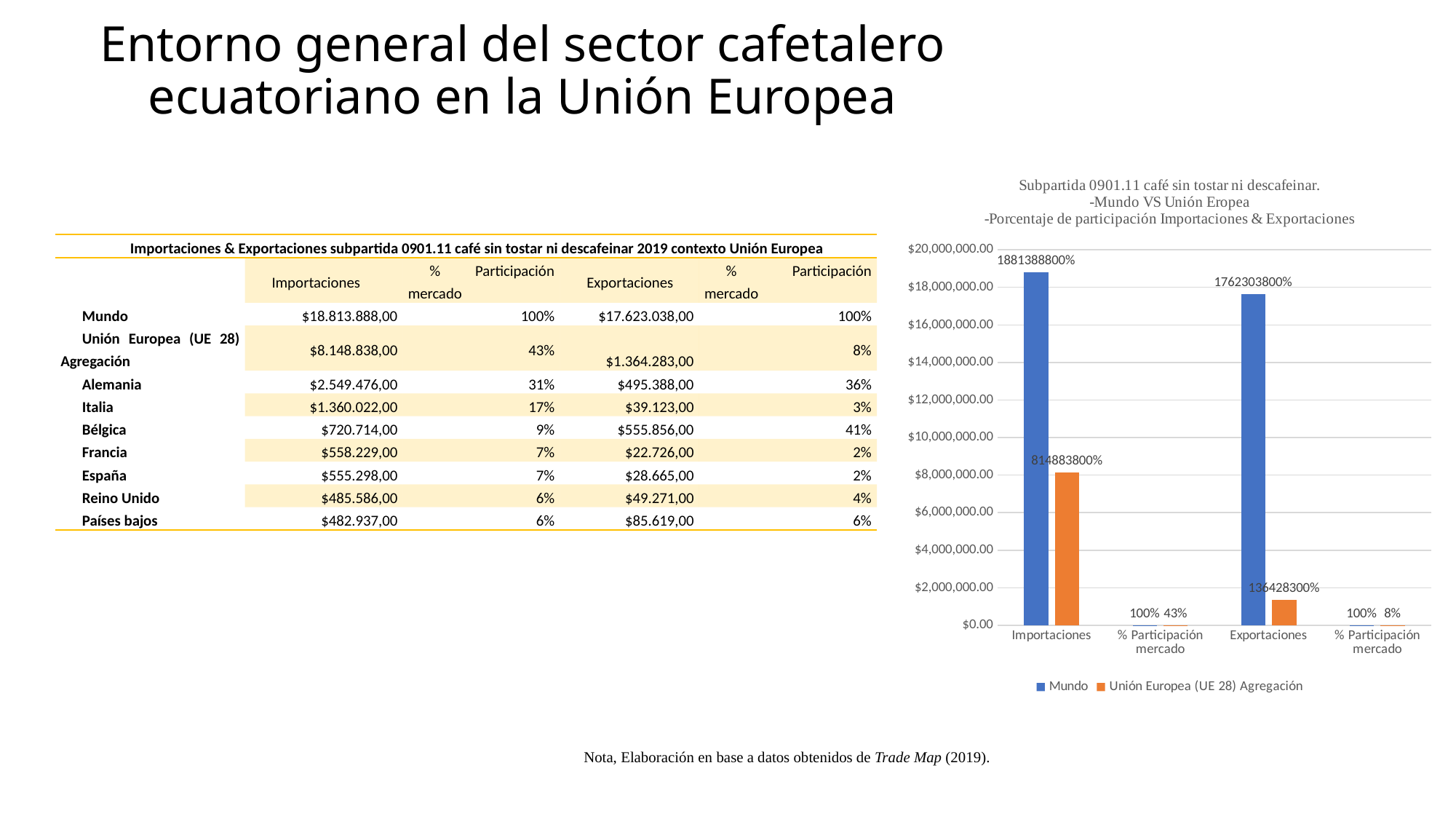
What is the data label on the Unión Europea (UE 28) Agregación bar for Exportaciones in the chart? 136428300% What is the data label on the Mundo bar for Importaciones in the chart? 1881388800% What type of chart is shown on the right of the slide? bar chart In the chart, is the Mundo bar for Importaciones greater or less than $18,000,000.00? greater In the chart, what is the % Participación mercado label for Unión Europea (UE 28) Agregación next to Exportaciones? 8% Which bar is the tallest in the chart? Mundo, Importaciones How many categories are shown along the x axis of the chart? 4 How many series does the chart legend list? 2 What is the data label on the Unión Europea (UE 28) Agregación bar for Importaciones in the chart? 814883800% What is the data label on the Mundo bar for Exportaciones in the chart? 1762303800% Which colour represents the Mundo series in the chart? blue In the chart, what is the % Participación mercado label for Unión Europea (UE 28) Agregación next to Importaciones? 43%